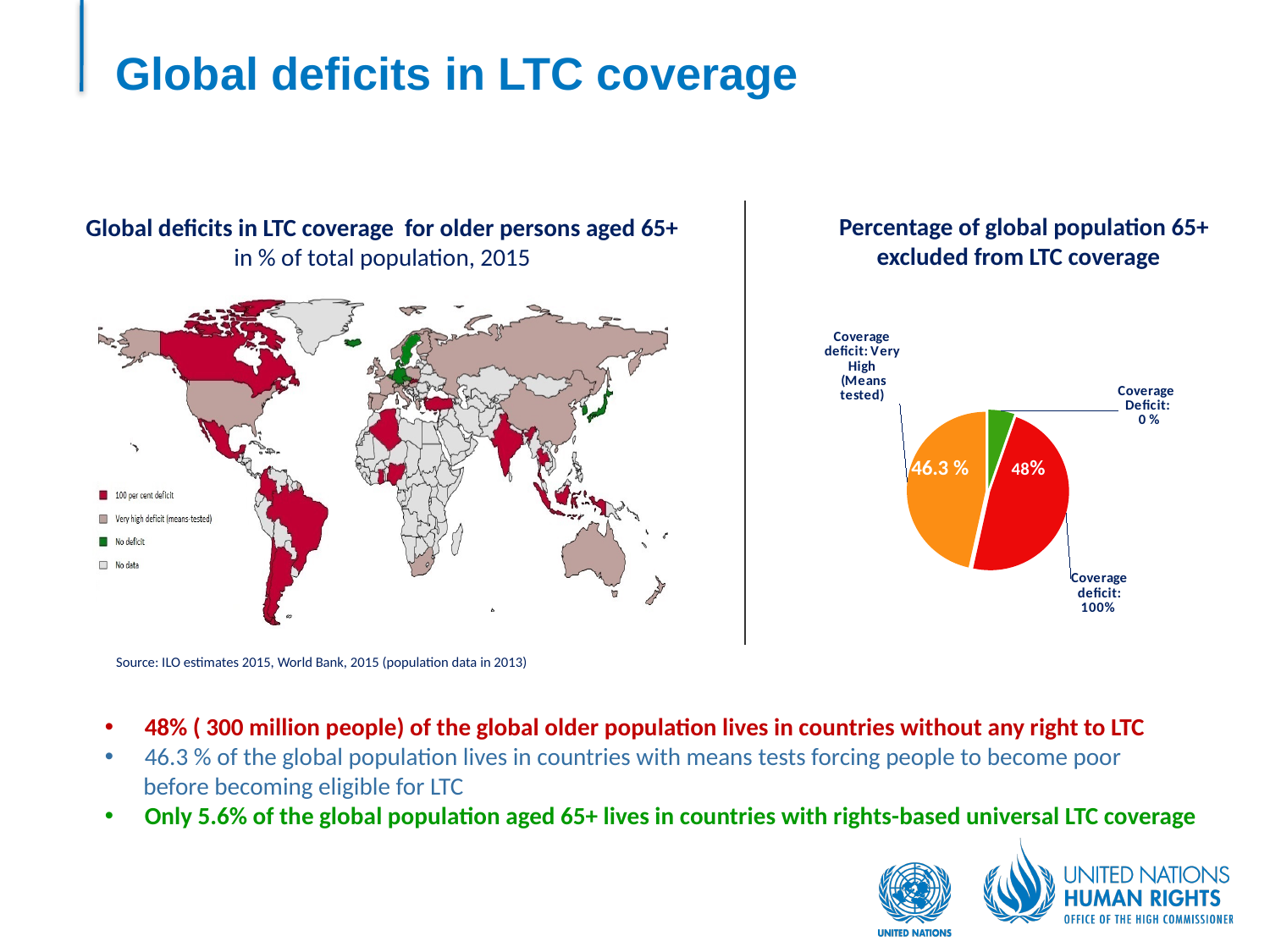
In the pie chart on the right, what colour is the 'Coverage deficit: 100%' slice? red In the pie chart on the right, which is larger: the 'Coverage deficit: 100%' slice or the 'Coverage deficit: Very High (Means tested)' slice? Coverage deficit: 100% How many slices does the pie chart on the right have? 3 In the pie chart on the right, what percentage is shown for the 'Coverage deficit: Very High (Means tested)' slice? 46.3 % In the pie chart on the right, what percentage is shown for the 'Coverage deficit: 100%' slice? 48% What kind of chart is the one titled 'Percentage of global population 65+ excluded from LTC coverage'? pie chart In the map on the left, how many categories does the legend list? 4 In the pie chart on the right, which slice is the largest? Coverage deficit: 100% In the pie chart on the right, which slice is the smallest? Coverage Deficit: 0 % In the pie chart on the right, by how many percentage points does the 'Coverage deficit: 100%' slice exceed the 'Coverage deficit: Very High (Means tested)' slice? 1.7